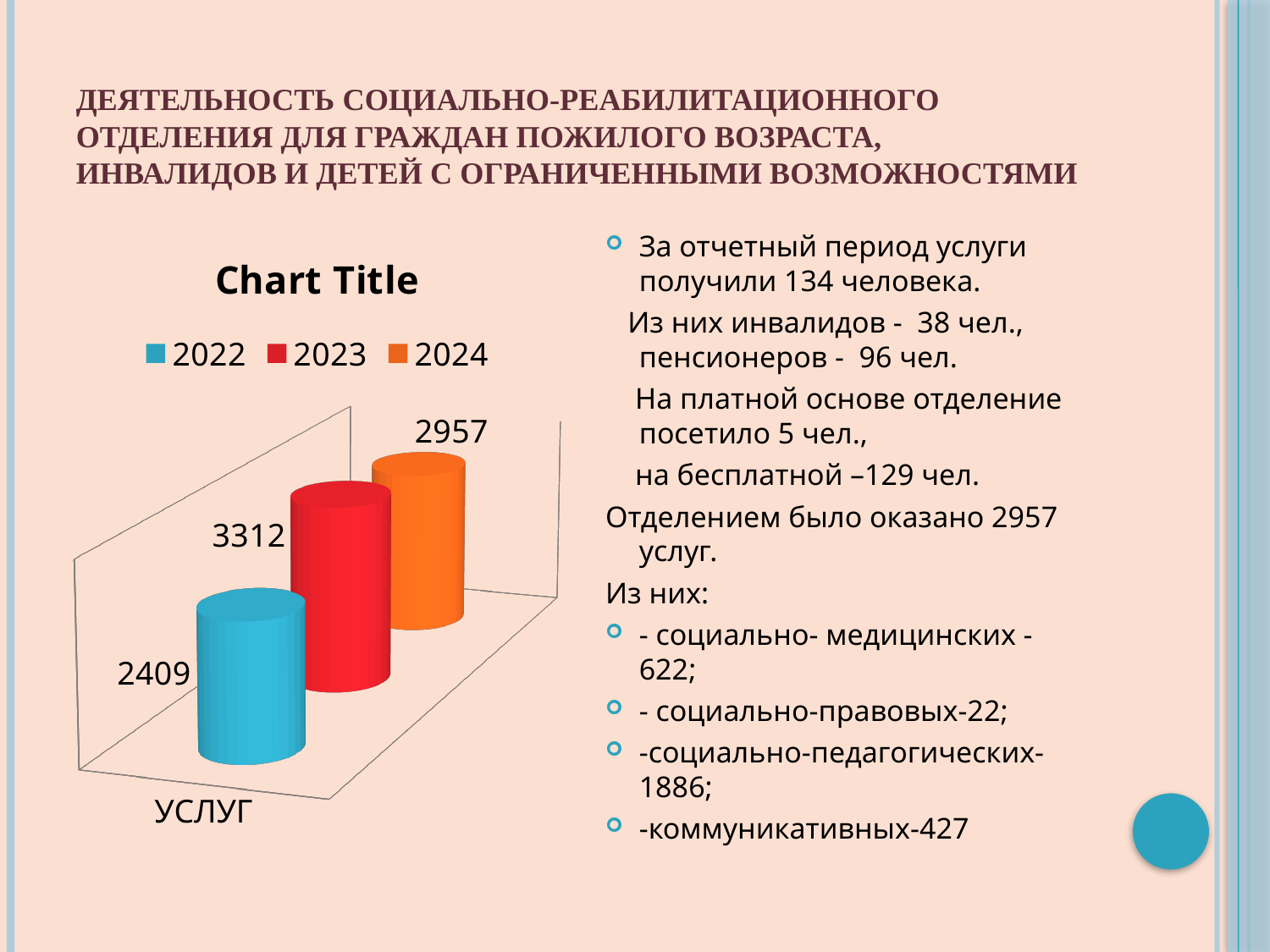
Which year has the lowest value in the chart? 2022 What colour is the bar for 2023? red What is the category label shown on the x axis of the chart? УСЛУГ What kind of chart is shown on the slide? bar chart Which is larger, the value for 2024 or the value for 2022? 2024 What is the difference between the values for 2023 and 2022? 903 What is the value for 2023 in the chart? 3312 What is the difference between the values for 2023 and 2024? 355 How many series does the legend list? 3 Which year has the highest value in the chart? 2023 What is the value for 2024 in the chart? 2957 What is the value for 2022 in the chart? 2409